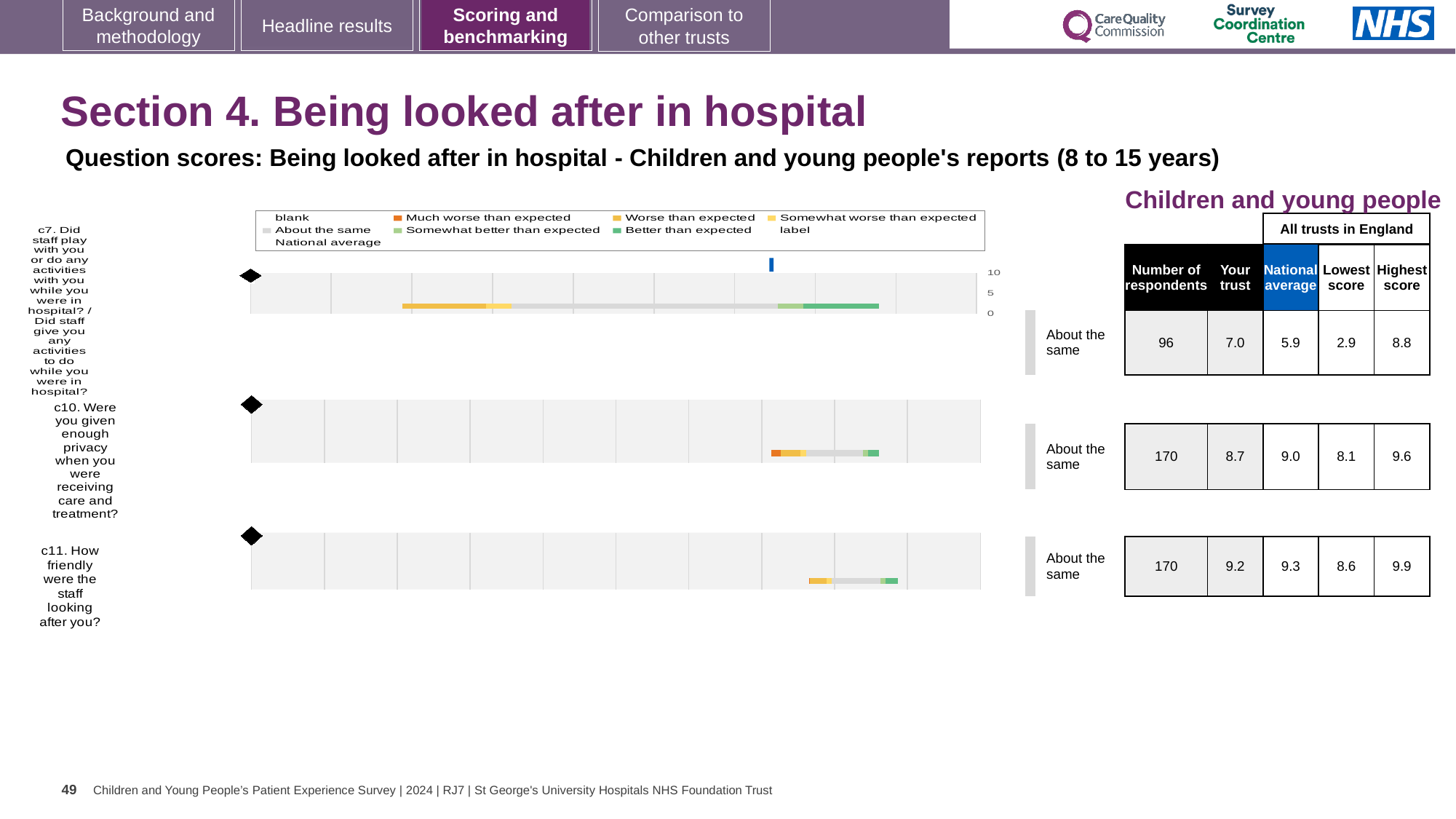
What kind of chart is used to show each question's score? bar chart For question c10, which is larger: the 'Your trust' score or the national average? National average What is the highest score across all trusts in England for question c10? 9.6 Which question has the highest 'Your trust' score? c11. How friendly were the staff looking after you? Which question has the lowest national average score? c7. Did staff play with you or do any activities with you while you were in hospital? What is the national average score for question c11 (How friendly were the staff looking after you?)? 9.3 How many survey questions are plotted on the slide? 3 How many respondents answered question c7 (Did staff play with you or do any activities with you while you were in hospital?)? 96 What is the lowest score across all trusts in England for question c7? 2.9 What benchmark category is shown for question c11? About the same For question c7, what is the difference between the 'Your trust' score and the national average? 1.1 What is the 'Your trust' score for question c10 (Were you given enough privacy when you were receiving care and treatment?)? 8.7